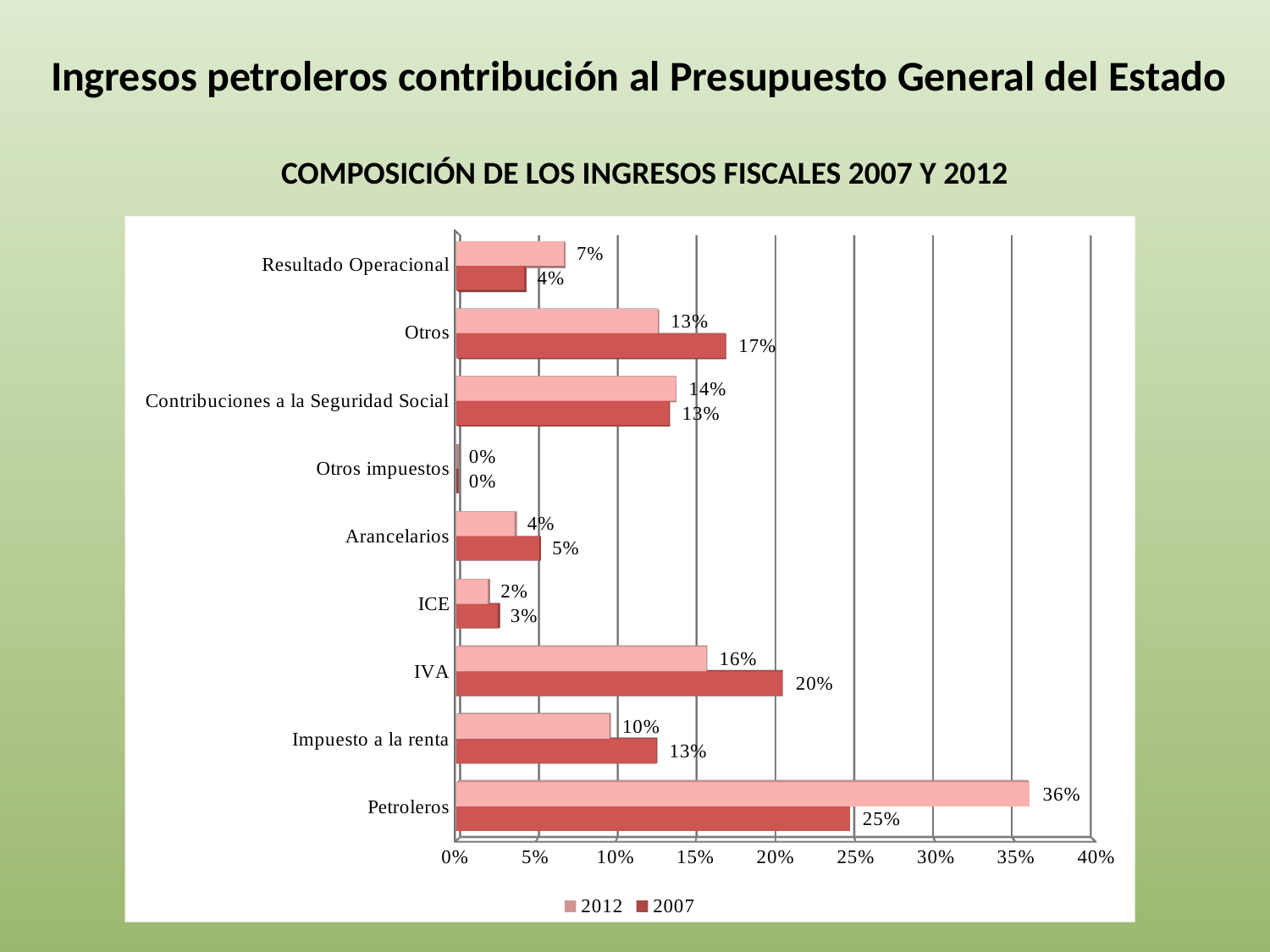
What is the value for Otros in the 2007 series? 17% What is the title of the chart? COMPOSICIÓN DE LOS INGRESOS FISCALES 2007 Y 2012 What is the difference between the 2012 and 2007 values for Petroleros? 11% How many series does the legend list? 2 What is the value for Petroleros in the 2012 series? 36% Which category has the highest value in the 2012 series? Petroleros Which is larger for IVA: the 2012 value or the 2007 value? 2007 Which category has the lowest value in the 2007 series? Otros impuestos What is the value for IVA in the 2007 series? 20% What kind of chart is shown on the slide? Bar chart How many categories are shown on the chart? 9 What is the value for Impuesto a la renta in the 2012 series? 10%